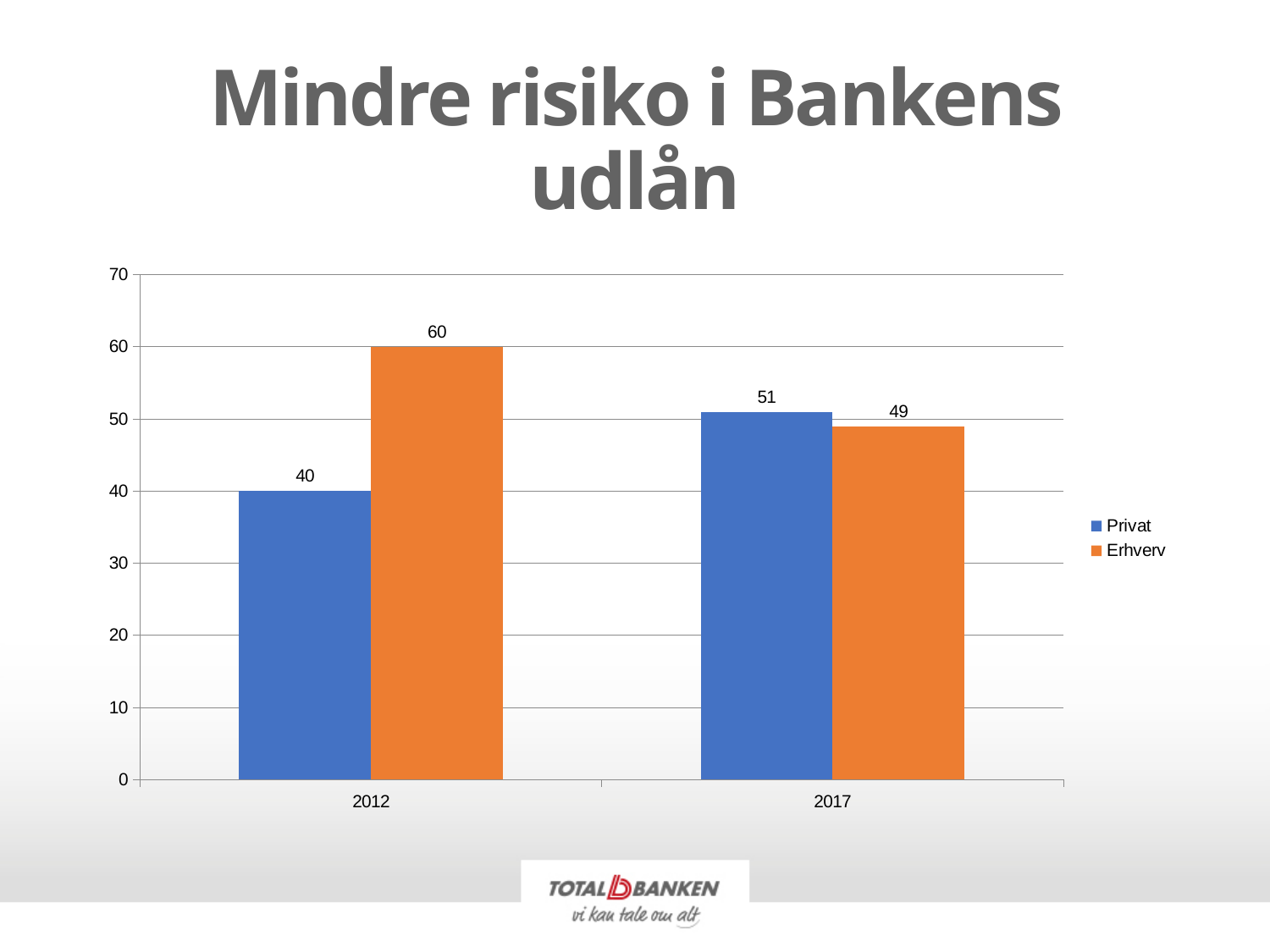
What is the value for Privat in 2012? 40 What is the value for Erhverv in 2012? 60 How many years are shown on the x axis? 2 What kind of chart is shown on the slide? Bar chart What is the difference between Erhverv and Privat in 2012? 20 What is the value for Erhverv in 2017? 49 What is the value for Privat in 2017? 51 How many series does the legend list? 2 Which series has the lowest value in 2017? Erhverv Is the Privat value larger in 2012 or in 2017? 2017 Which series has the highest value in 2012? Erhverv By how much did the Privat value increase from 2012 to 2017? 11